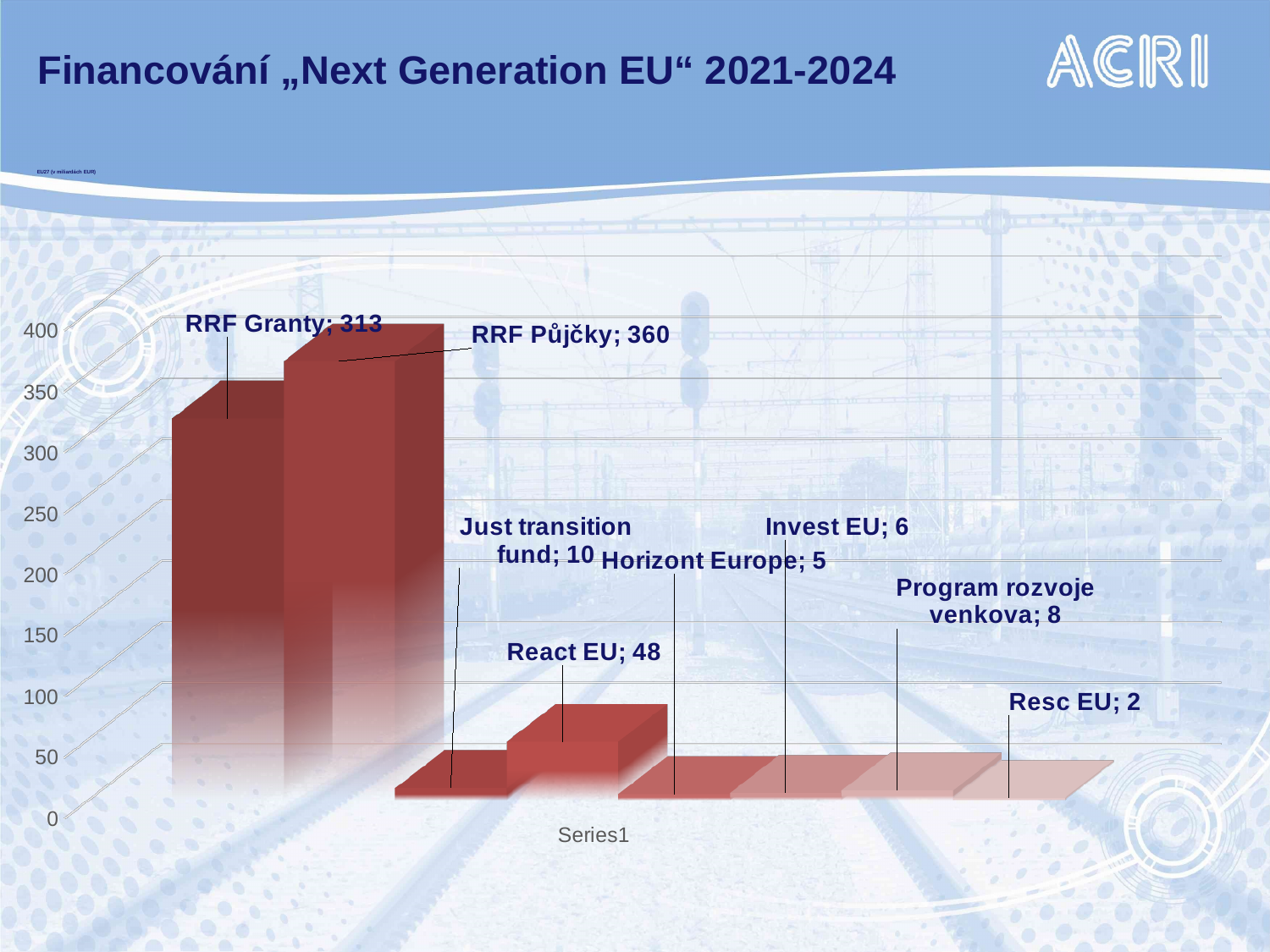
What is the name of the series shown below the chart? Series1 Which category has the lowest value? Resc EU What is the value for Program rozvoje venkova? 8 How many categories are plotted in the chart? 8 What is the value for React EU? 48 Which is larger, the value for Invest EU or the value for Horizont Europe? Invest EU What is the difference between the values for React EU and Just transition fund? 38 What is the value for RRF Půjčky? 360 Which category has the highest value? RRF Půjčky What is the difference between the values for RRF Půjčky and RRF Granty? 47 What is the value for RRF Granty? 313 What kind of chart is shown on the slide? bar chart